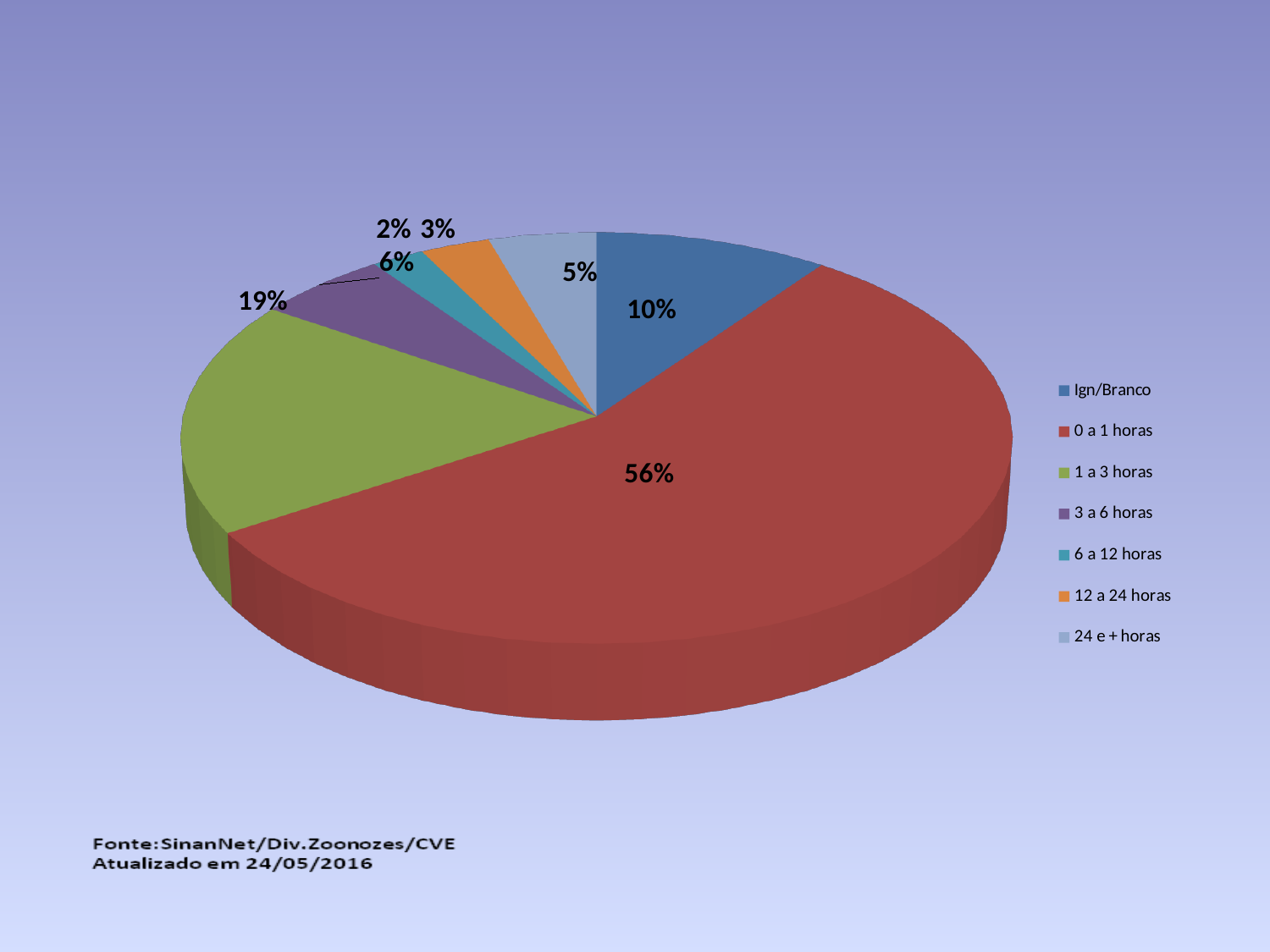
How many categories does the legend list? 7 What percentage is shown for the "1 a 3 horas" slice? 19% What is the difference in percentage points between the "0 a 1 horas" slice and the "1 a 3 horas" slice? 37 What share of the pie does the "0 a 1 horas" slice represent? 56% What percentage is shown for the "Ign/Branco" slice? 10% What percentage is shown for the "24 e + horas" slice? 5% What kind of chart is shown on the slide? Pie chart Which category has the smallest slice of the pie? 6 a 12 horas Which slice is larger, "12 a 24 horas" or "24 e + horas"? 24 e + horas What percentage is shown for the "3 a 6 horas" slice? 6% What source is cited at the bottom of the slide? SinanNet/Div.Zoonozes/CVE Which category has the largest slice of the pie? 0 a 1 horas